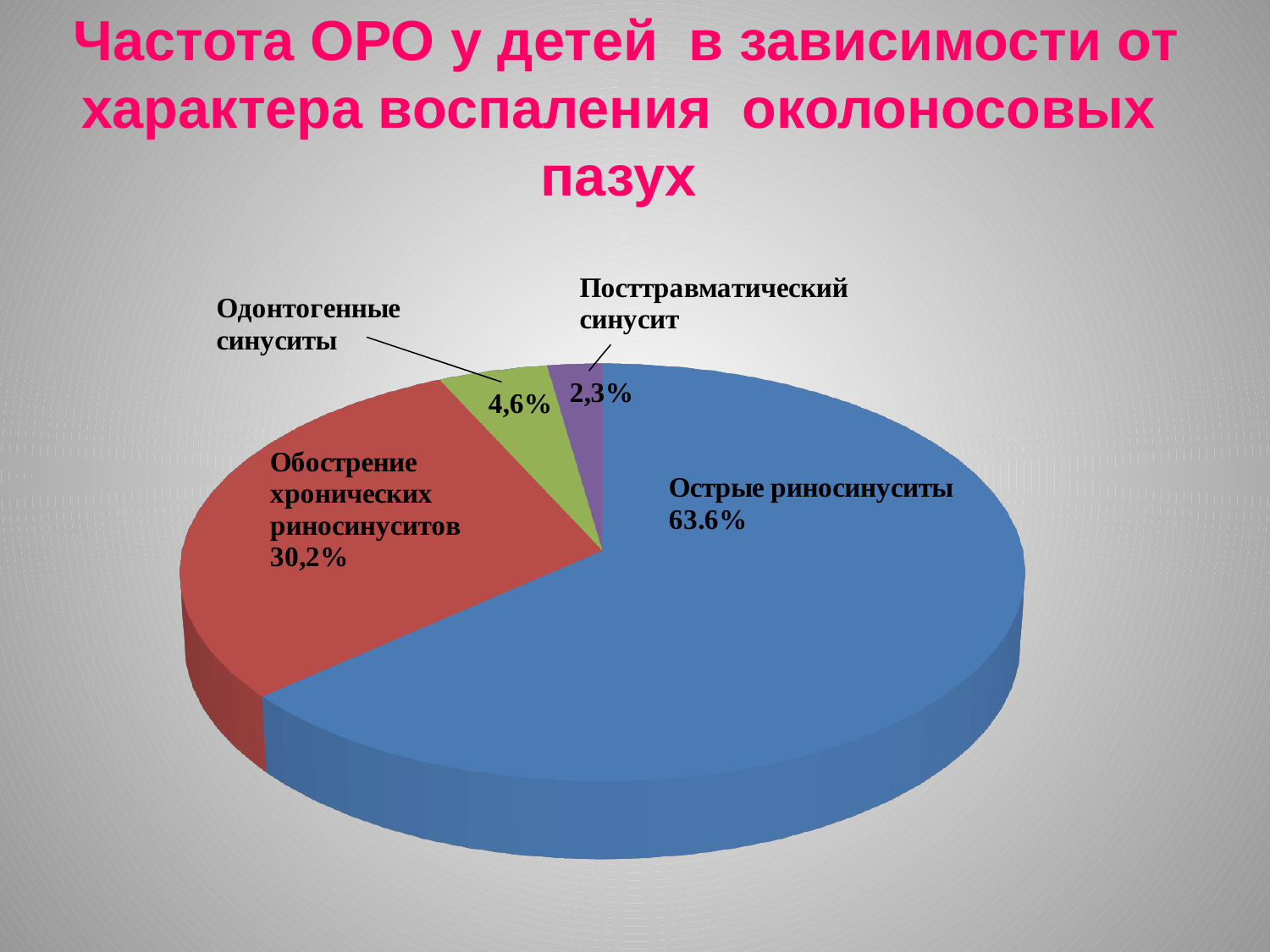
What type of chart is shown on the slide? Pie chart How many slices does the pie chart have? 4 What percentage is shown for Одонтогенные синуситы? 4,6% What percentage is shown for Посттравматический синусит? 2,3% What is the difference between the shares for Одонтогенные синуситы and Посттравматический синусит? 2,3% Which is larger: the share for Одонтогенные синуситы or for Посттравматический синусит? Одонтогенные синуситы Which category has the smallest share of the pie? Посттравматический синусит What is the difference between the shares for Обострение хронических риносинуситов and Одонтогенные синуситы? 25,6% Which category has the largest share of the pie? Острые риносинуситы What colour is the slice for Обострение хронических риносинуситов? Red What percentage is shown for Острые риносинуситы? 63.6% What percentage is shown for Обострение хронических риносинуситов? 30,2%